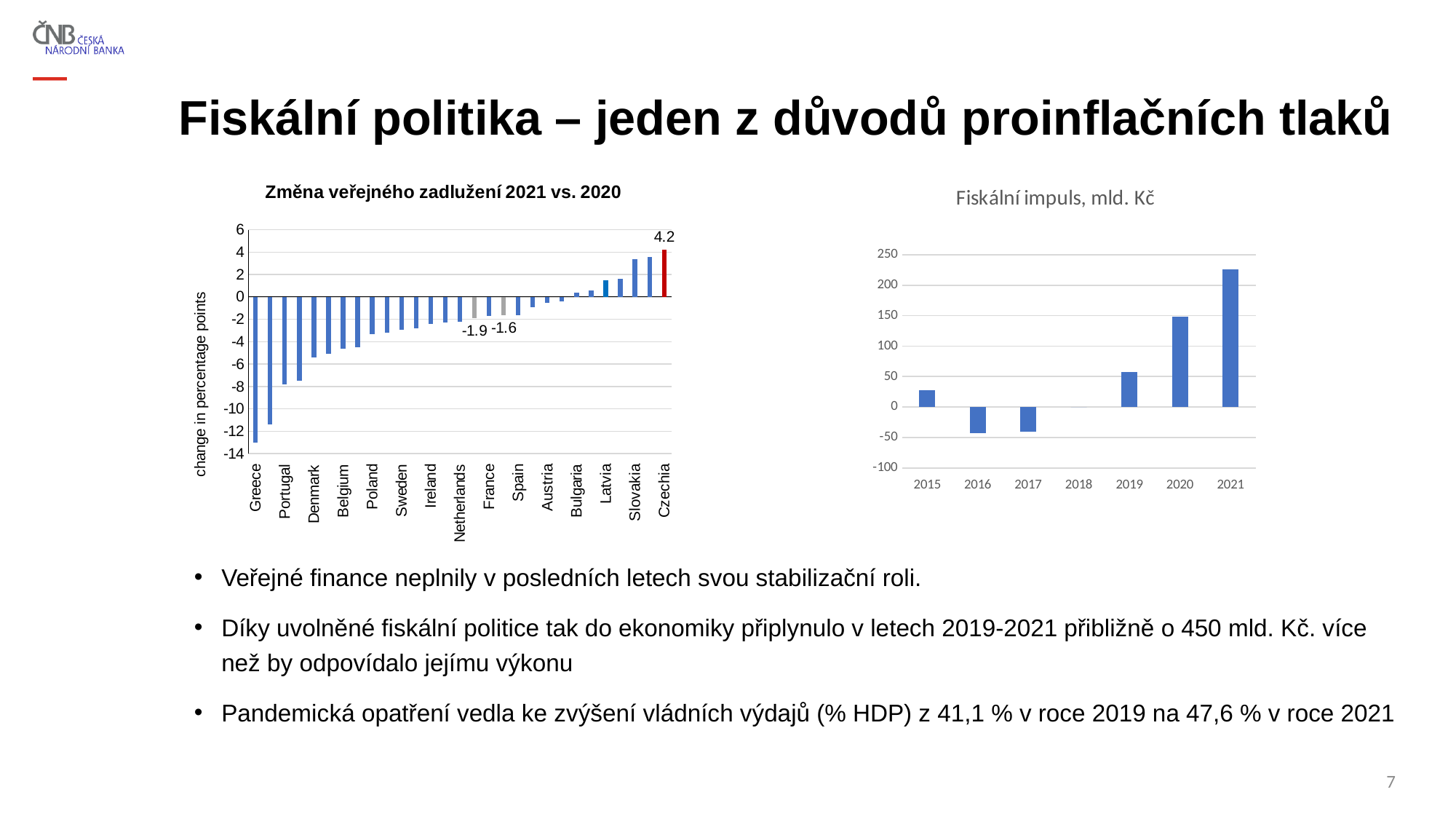
In the chart 'Fiskální impuls, mld. Kč', which is larger, the value for 2016 or the value for 2019? 2019 In the chart 'Fiskální impuls, mld. Kč', is the value for 2021 greater or less than 200? greater In the chart 'Změna veřejného zadlužení 2021 vs. 2020', is the value for Greece greater or less than -12? less In the chart 'Změna veřejného zadlužení 2021 vs. 2020', what is the value for Czechia? 4.2 In the chart 'Změna veřejného zadlužení 2021 vs. 2020', which country has the lowest value? Greece In the chart 'Změna veřejného zadlužení 2021 vs. 2020', what is the label of the vertical axis? change in percentage points In the chart 'Změna veřejného zadlužení 2021 vs. 2020', which country has the highest value? Czechia In the chart 'Fiskální impuls, mld. Kč', which year has the highest value? 2021 In the chart 'Fiskální impuls, mld. Kč', how many years are shown on the x axis? 7